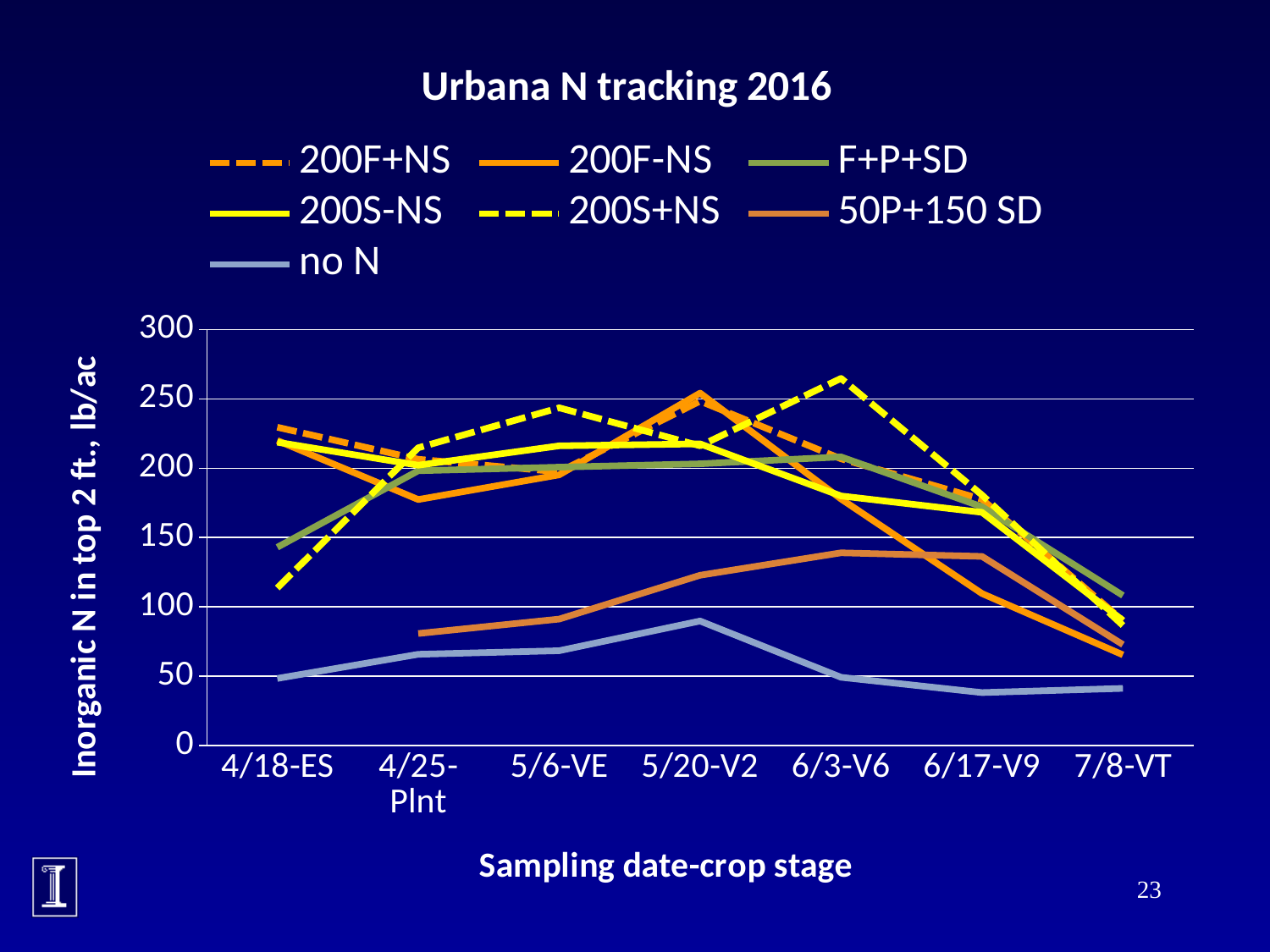
Is the value for 200S+NS at 4/18-ES greater or less than 150? less Which series has the highest value at 6/3-V6? 200S+NS Is the value for no N at 6/17-V9 greater or less than 50? less What kind of chart is shown on the slide? line chart What is the label of the y axis? Inorganic N in top 2 ft., lb/ac At 4/18-ES, which is larger: 200F+NS or F+P+SD? 200F+NS Is the value for 200S+NS at 6/3-V6 greater or less than 250? greater Which series has the lowest value at 6/3-V6? no N How many series does the legend list? 7 What is the title of the chart? Urbana N tracking 2016 How many sampling dates are shown on the x axis? 7